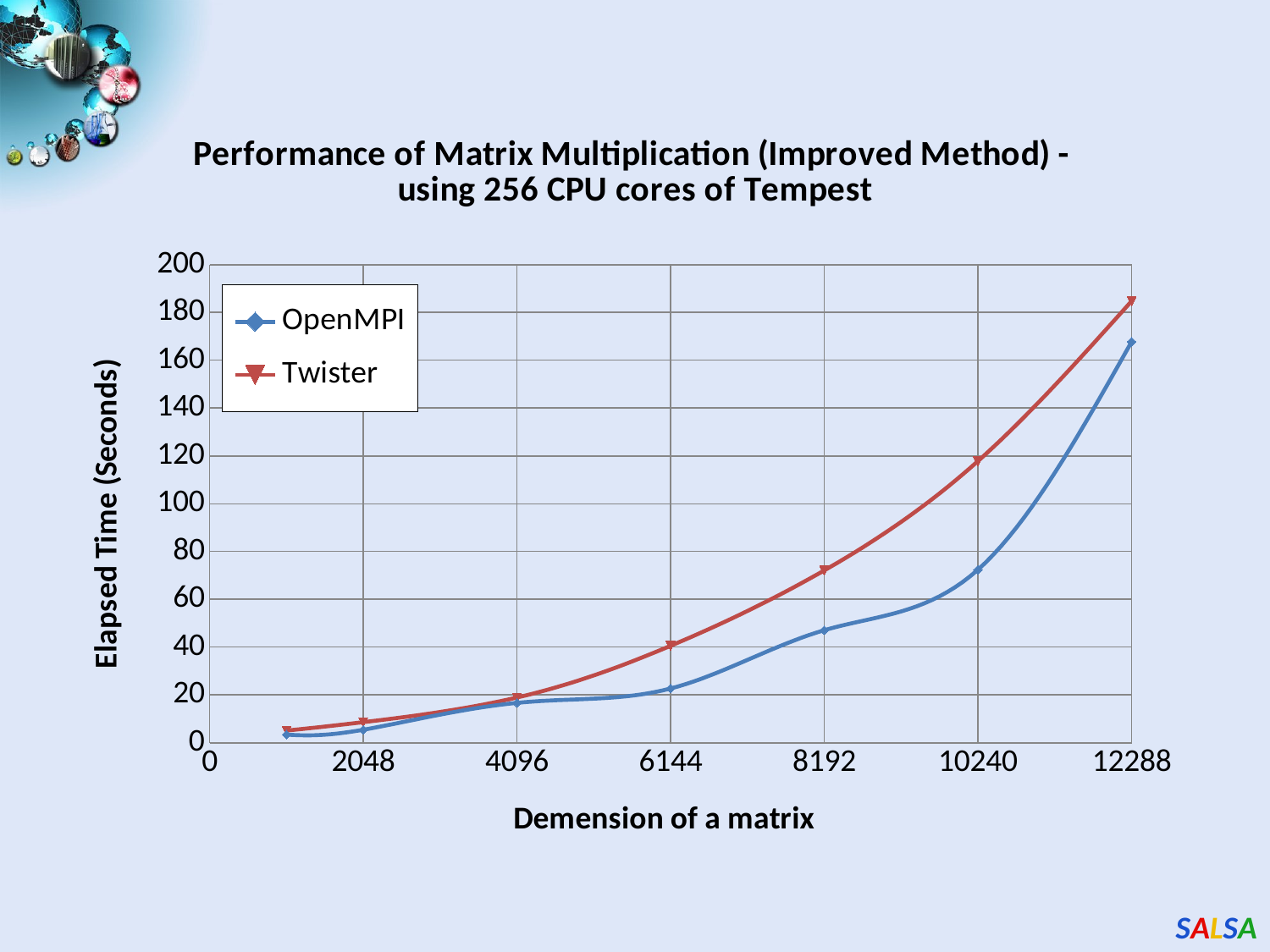
Which two series are listed in the legend? OpenMPI and Twister Do the elapsed times for OpenMPI rise or fall as the matrix dimension increases? rise Is the elapsed time for Twister at a matrix dimension of 6144 greater or less than 60? less How many data points are plotted for the Twister series? 7 Is the elapsed time for Twister at a matrix dimension of 10240 greater or less than 100? greater How many series does the legend list? 2 What kind of chart is shown on the slide? line chart Is the elapsed time for OpenMPI at a matrix dimension of 8192 greater or less than 60? less At a matrix dimension of 12288, which series has the higher elapsed time, OpenMPI or Twister? Twister At a matrix dimension of 10240, which series has the lower elapsed time, OpenMPI or Twister? OpenMPI What is the title of the y axis? Elapsed Time (Seconds)